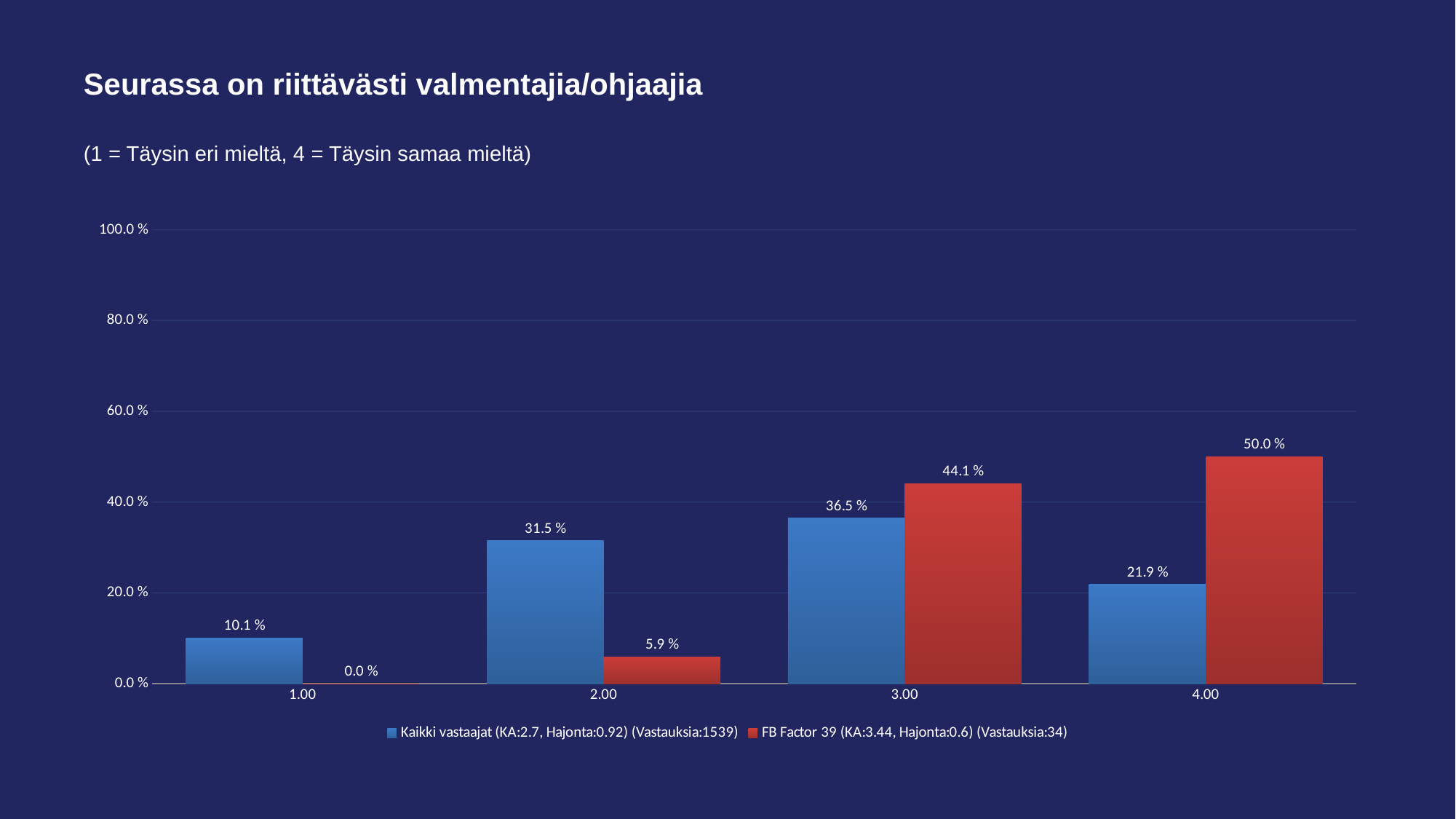
What is the difference between the FB Factor 39 and Kaikki vastaajat values at 4.00? 28.1 % How many categories are shown on the x axis? 4 At 2.00, which series has the larger value, Kaikki vastaajat or FB Factor 39? Kaikki vastaajat What is the value for FB Factor 39 at 2.00? 5.9 % What is the title of the chart? Seurassa on riittävästi valmentajia/ohjaajia How many series does the legend list? 2 What is the value for FB Factor 39 at 4.00? 50.0 % Which category has the highest value for the FB Factor 39 series? 4.00 What is the value for Kaikki vastaajat at 1.00? 10.1 % What is the value for Kaikki vastaajat at 3.00? 36.5 % Which category has the lowest value for the Kaikki vastaajat series? 1.00 What kind of chart is shown on the slide? Bar chart